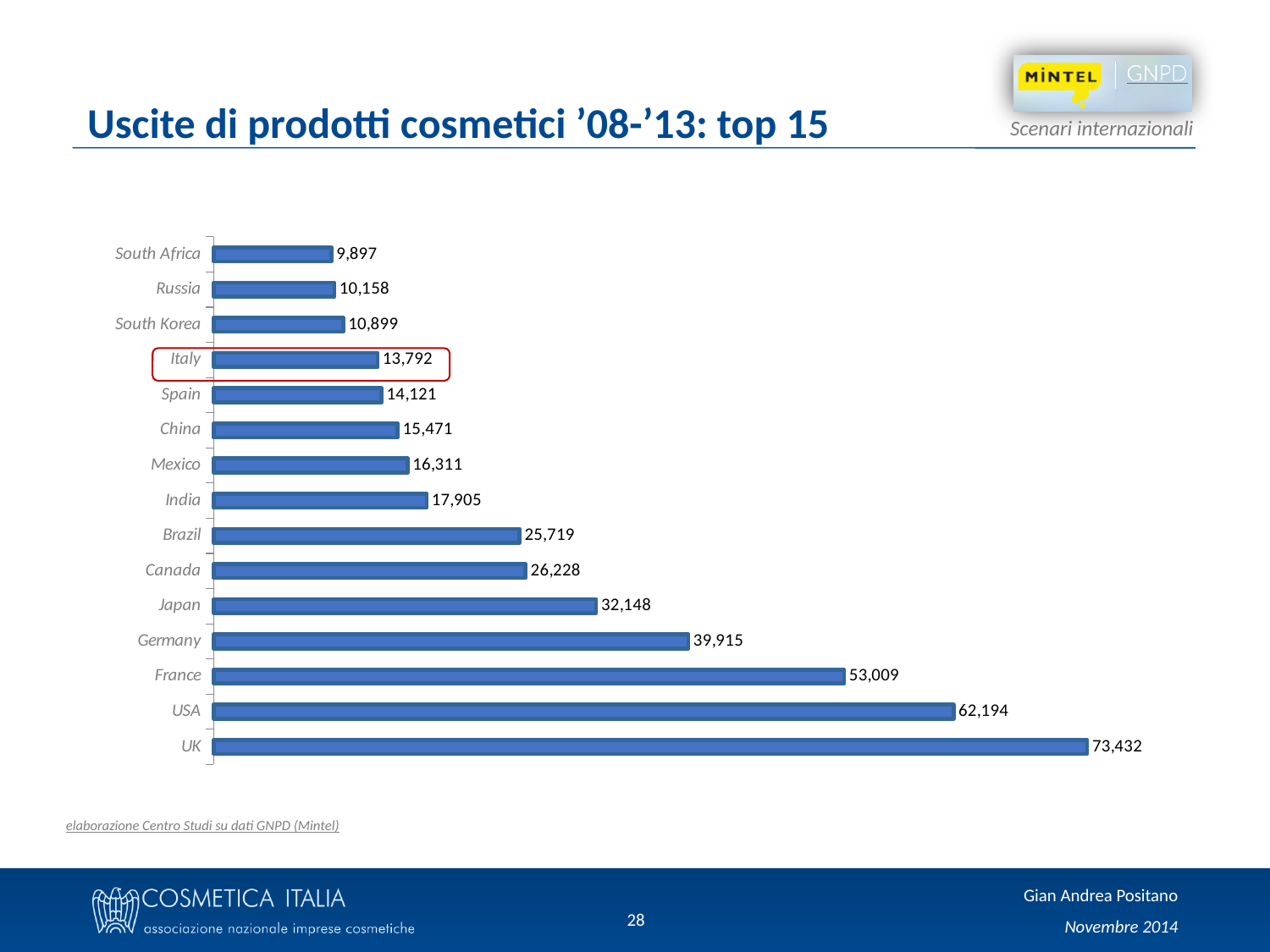
What kind of chart is shown on the slide? Bar chart Which country has the lowest value? South Africa Which has a larger value, Japan or Canada? Japan Which country is highlighted with a red outline in the chart? Italy What is the value for Italy? 13,792 What is the value for Germany? 39,915 What is the difference between the values for UK and USA? 11,238 What is the difference between the values for France and Germany? 13,094 How many countries are shown in the chart? 15 Which country has the highest value? UK What is the value for Brazil? 25,719 Which has a larger value, Mexico or India? India